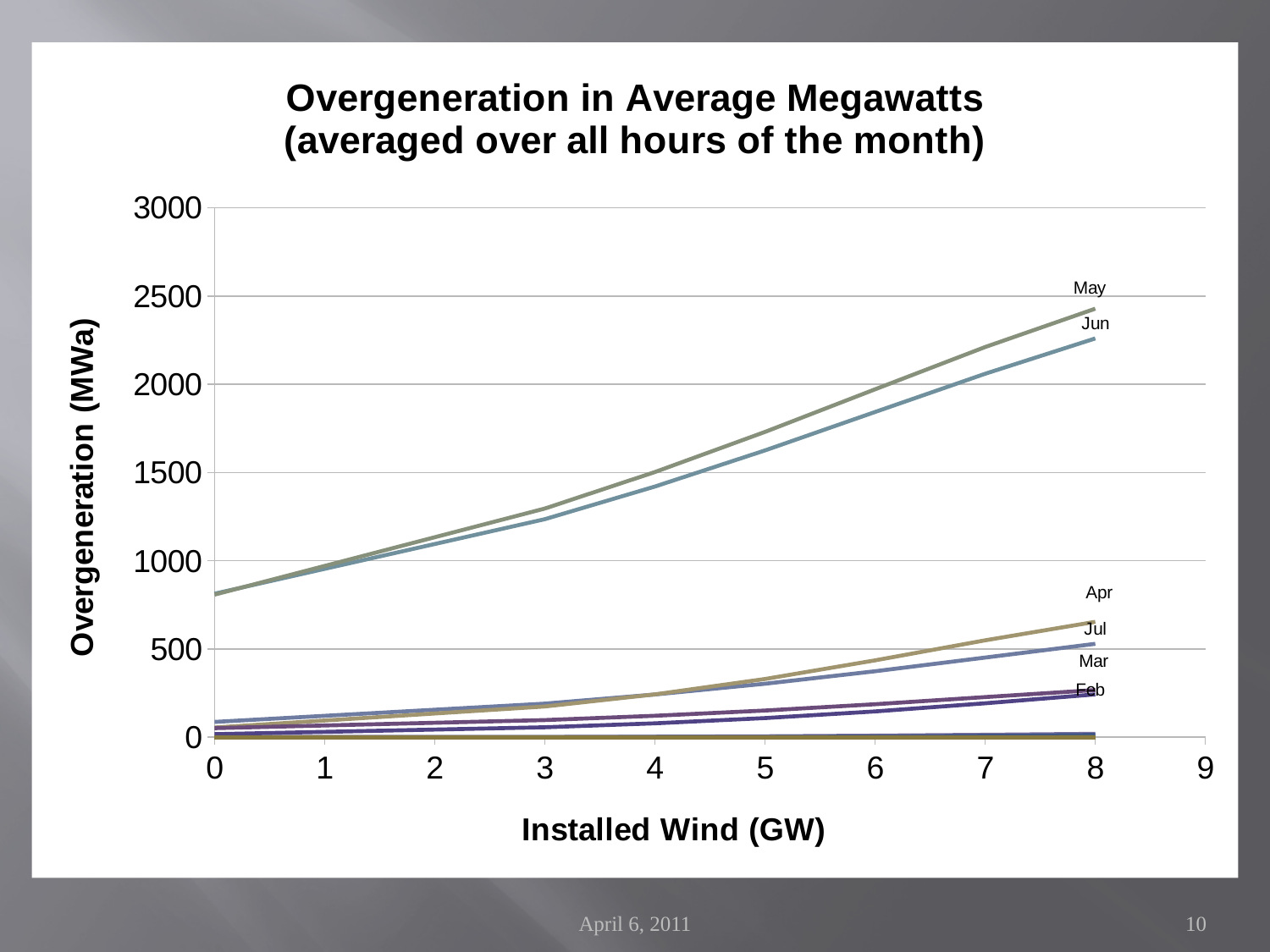
At 8 GW of installed wind, which is larger, the value for Apr or the value for Mar? Apr What is the title of the chart? Overgeneration in Average Megawatts (averaged over all hours of the month) Is the value for Mar at 8 GW greater or less than 500? less Is the value for Jun at 8 GW greater or less than 2500? less What kind of chart is shown on the slide? line chart What is the label of the x axis? Installed Wind (GW) Does the overgeneration for May rise or fall as installed wind increases? rise Is the value for Apr at 8 GW greater or less than 1000? less At 8 GW of installed wind, which is larger, the value for May or the value for Jun? May Which labeled month has the highest overgeneration at 8 GW of installed wind? May